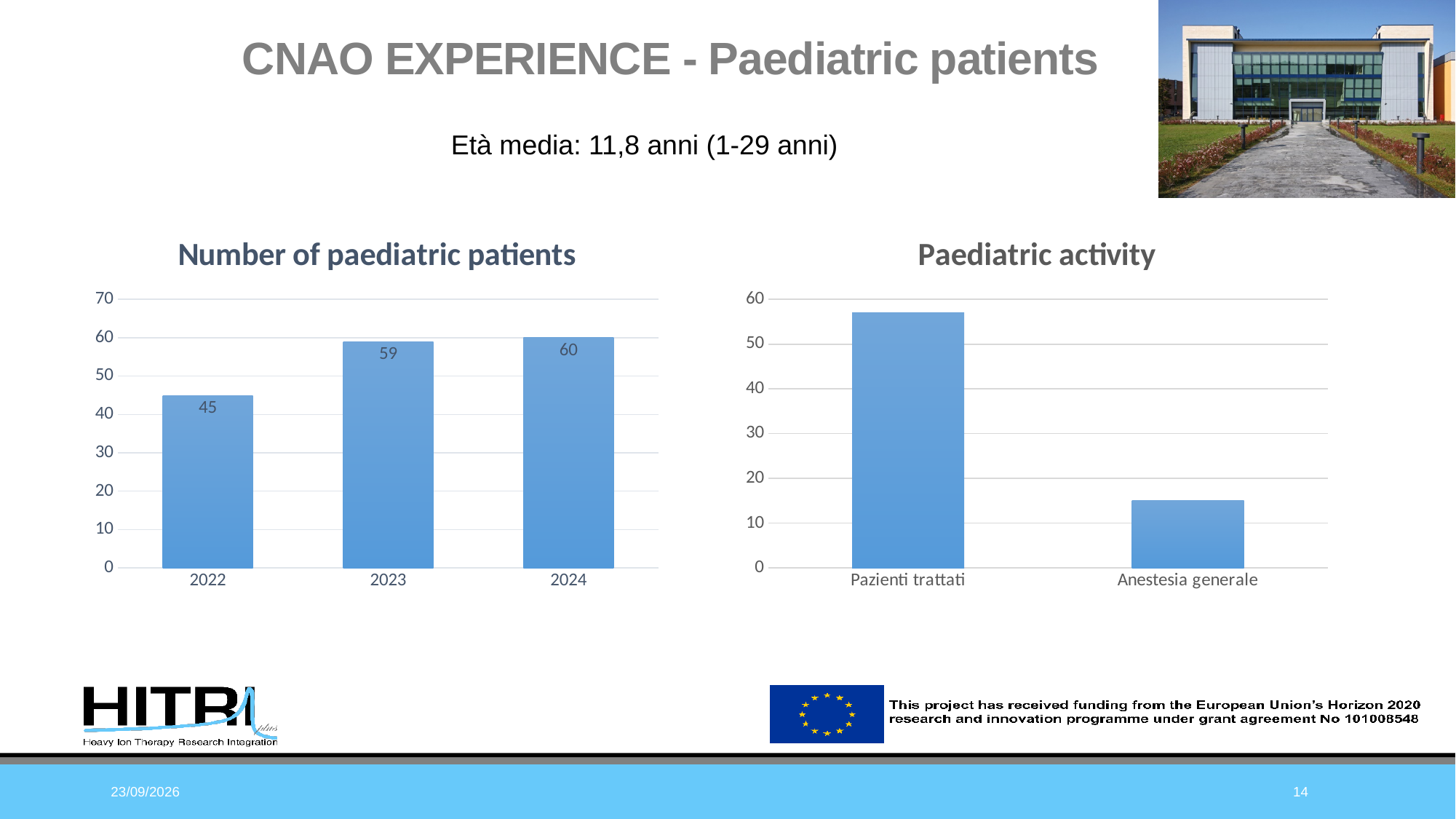
In the 'Number of paediatric patients' chart, what is the value for 2024? 60 In the 'Number of paediatric patients' chart, do the values rise or fall from 2022 to 2024? rise In the 'Number of paediatric patients' chart, how many years are shown? 3 In the 'Number of paediatric patients' chart, which year has the lowest value? 2022 In the 'Paediatric activity' chart, is the value for 'Anestesia generale' greater or less than 20? less In the 'Paediatric activity' chart, is the value for 'Pazienti trattati' greater or less than 50? greater In the 'Paediatric activity' chart, which category has the higher value? Pazienti trattati In the 'Paediatric activity' chart, how many categories are shown? 2 What kind of chart is the 'Paediatric activity' chart? bar chart In the 'Number of paediatric patients' chart, what is the difference between the values for 2024 and 2022? 15 In the 'Number of paediatric patients' chart, what is the value for 2023? 59 In the 'Number of paediatric patients' chart, what is the value for 2022? 45